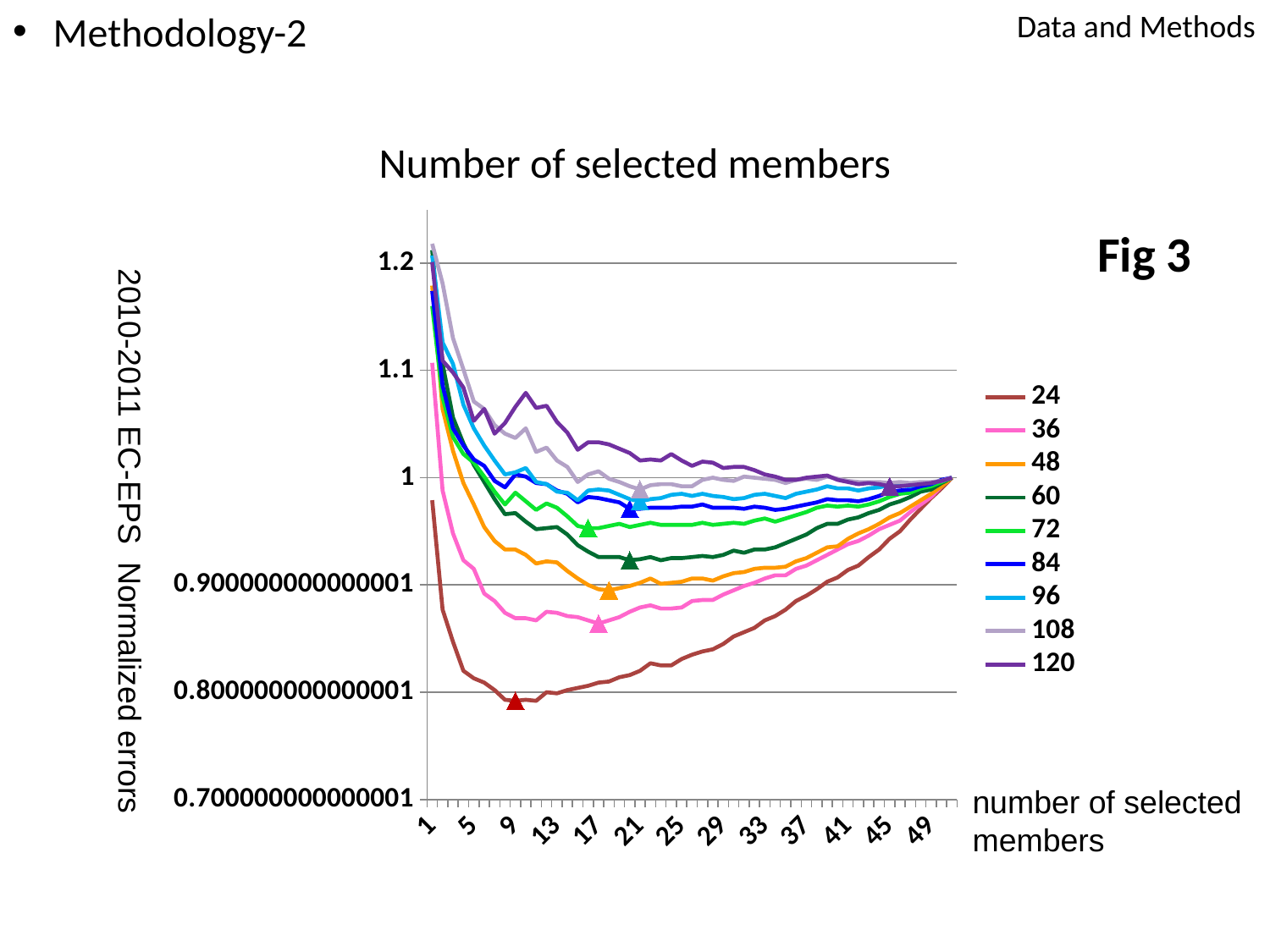
What is the title of the chart? Number of selected members At x = 17, which series has the larger value, 36 or 72? 72 Which series reaches the lowest value on the chart? 24 What is the label on the vertical axis of the chart? 2010-2011 EC-EPS Normalized errors Is the value for series 120 at x = 13 greater or less than 1? greater How many series does the legend list? 9 Is the value for series 24 at x = 9 greater or less than 0.9? less At x = 13, which series has the larger value, 108 or 120? 120 Which series has the highest value at x = 13? 120 Is the value for series 36 at x = 17 greater or less than 0.9? less Does the value for series 24 rise or fall from x = 1 to x = 9? fall What kind of chart is shown on the slide? line chart